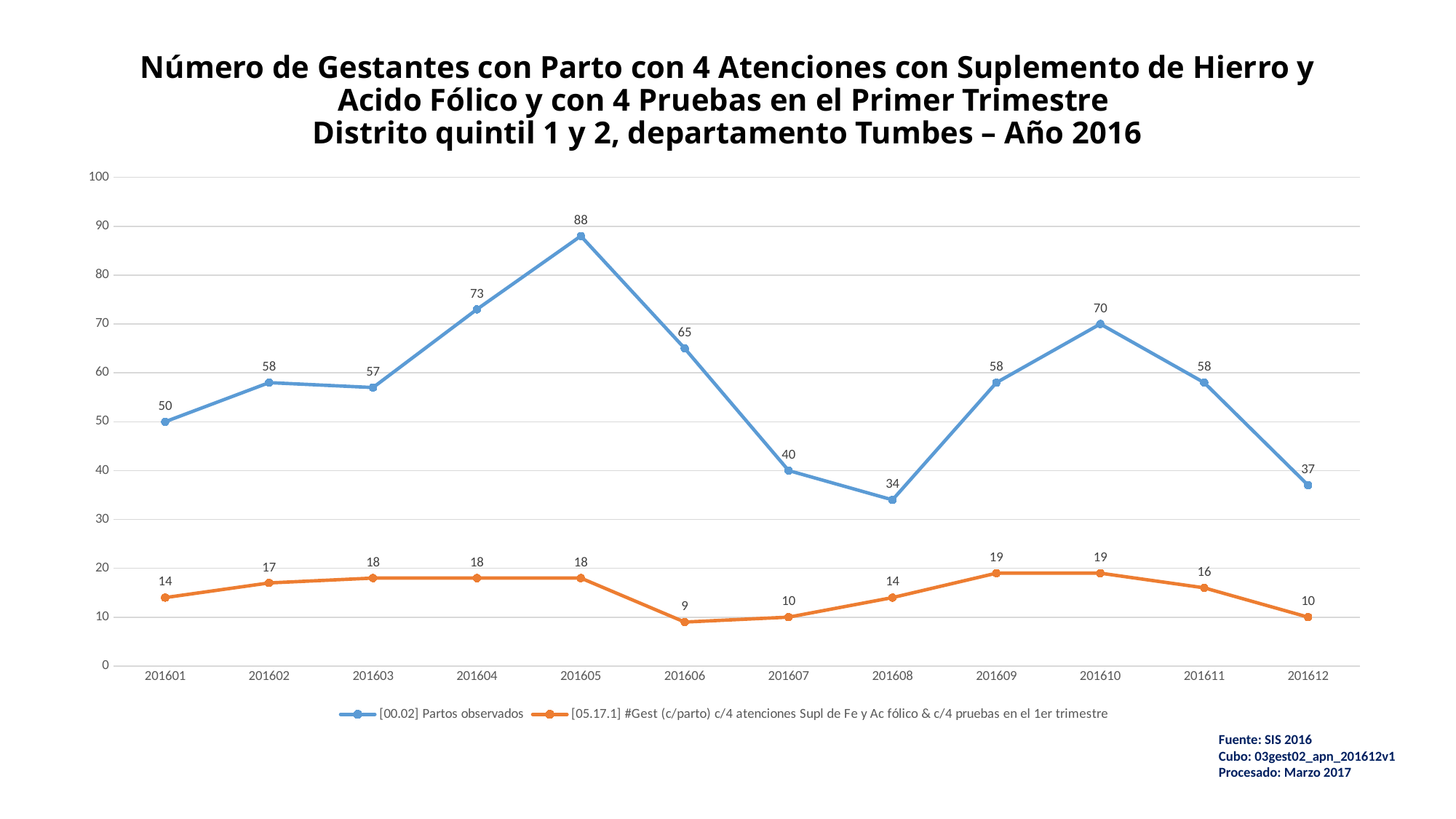
What is the difference between [00.02] Partos observados and the [05.17.1] series in 201610? 51 How many series does the legend list? 2 How many months are plotted on the x axis? 12 In which month does [00.02] Partos observados reach its highest value? 201605 Which is larger for the [05.17.1] series: the value for 201609 or the value for 201612? 201609 What kind of chart is shown on the slide? line chart What is the value of [00.02] Partos observados for 201605? 88 What is the value of the [05.17.1] series for 201606? 9 In which month does [00.02] Partos observados reach its lowest value? 201608 What colour is the line for [00.02] Partos observados? blue Does [00.02] Partos observados rise or fall from 201605 to 201608? fall Is the value of [00.02] Partos observados for 201604 greater or less than 70? greater